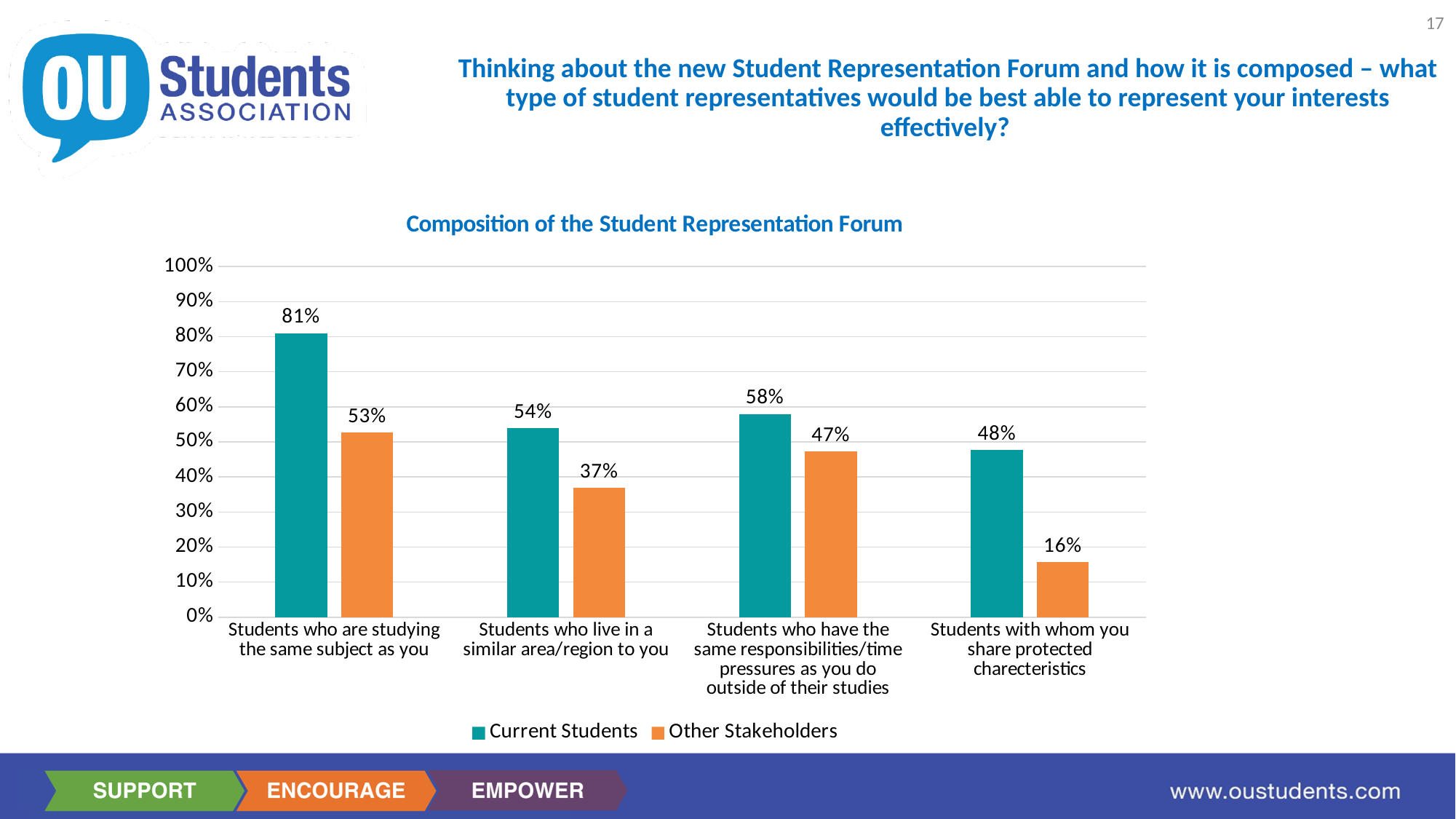
What is the Other Stakeholders value for 'Students who live in a similar area/region to you'? 37% What is the difference between the Current Students and Other Stakeholders values for 'Students who have the same responsibilities/time pressures as you do outside of their studies'? 11% What is the Other Stakeholders value for 'Students with whom you share protected charecteristics'? 16% Which category has the highest Current Students value? Students who are studying the same subject as you What kind of chart is shown on the slide? Bar chart Which category has the lowest Other Stakeholders value? Students with whom you share protected charecteristics What is the Current Students value for 'Students who are studying the same subject as you'? 81% What is the title of the chart? Composition of the Student Representation Forum How many series does the legend list? 2 How many categories are shown on the x axis? 4 Is the Current Students value for 'Students with whom you share protected charecteristics' greater or less than 50%? less Which is larger: the Current Students value for 'Students who live in a similar area/region to you' or the Other Stakeholders value for 'Students who are studying the same subject as you'? Current Students value for 'Students who live in a similar area/region to you'